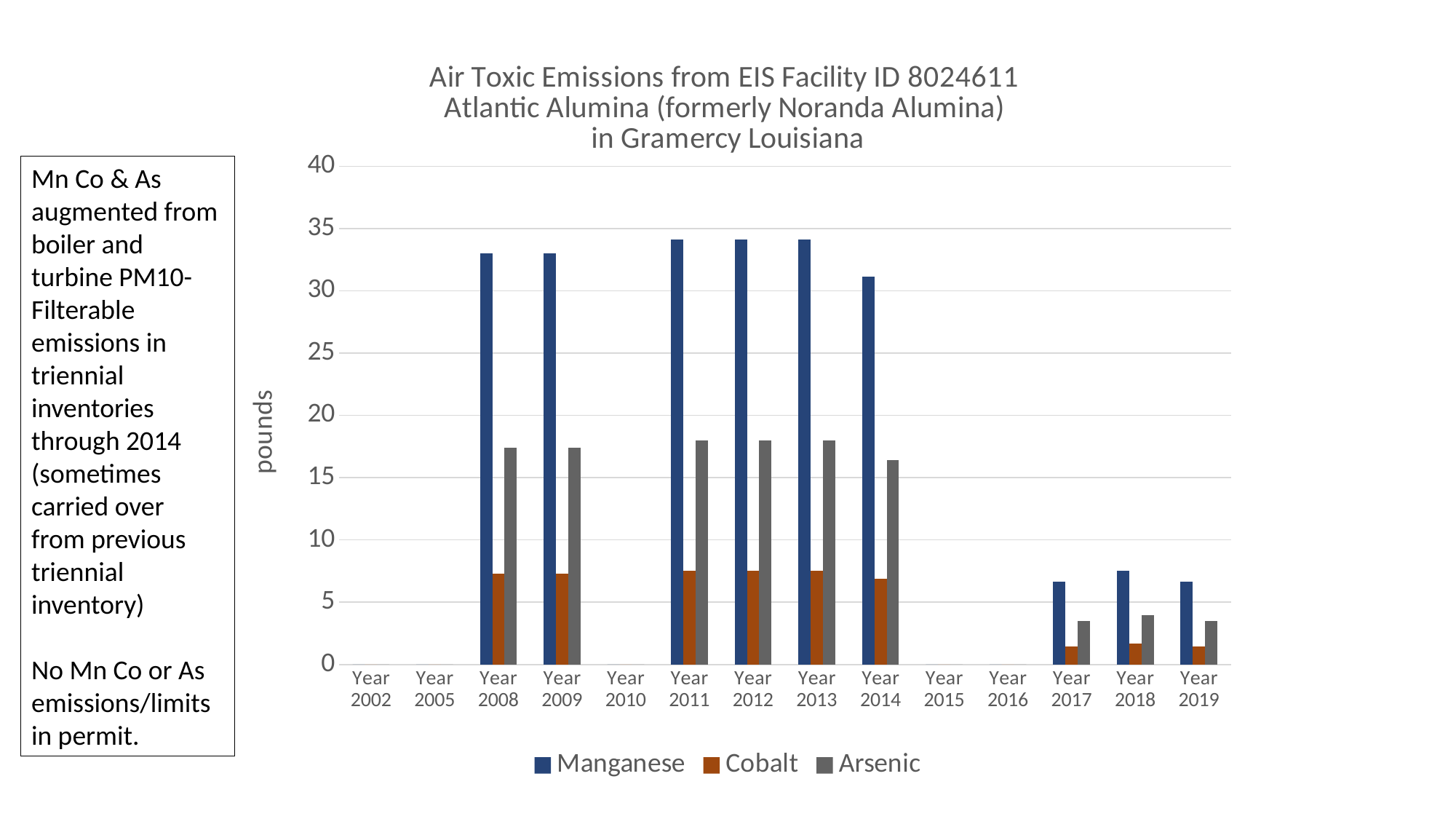
Is the Arsenic value for Year 2012 greater or less than 15? greater Is the Manganese value for Year 2011 greater or less than 30? greater How many year categories are shown on the x axis? 14 Is the Manganese value for Year 2017 greater or less than 10? less How many series does the legend list? 3 What kind of chart is shown on the slide? bar chart Which series has the highest value in Year 2012? Manganese Which series is represented by the dark blue bars? Manganese What is the label on the vertical axis? pounds Which is larger, the Manganese value for Year 2011 or the Manganese value for Year 2017? Year 2011 Which series has the lowest value in Year 2017? Cobalt